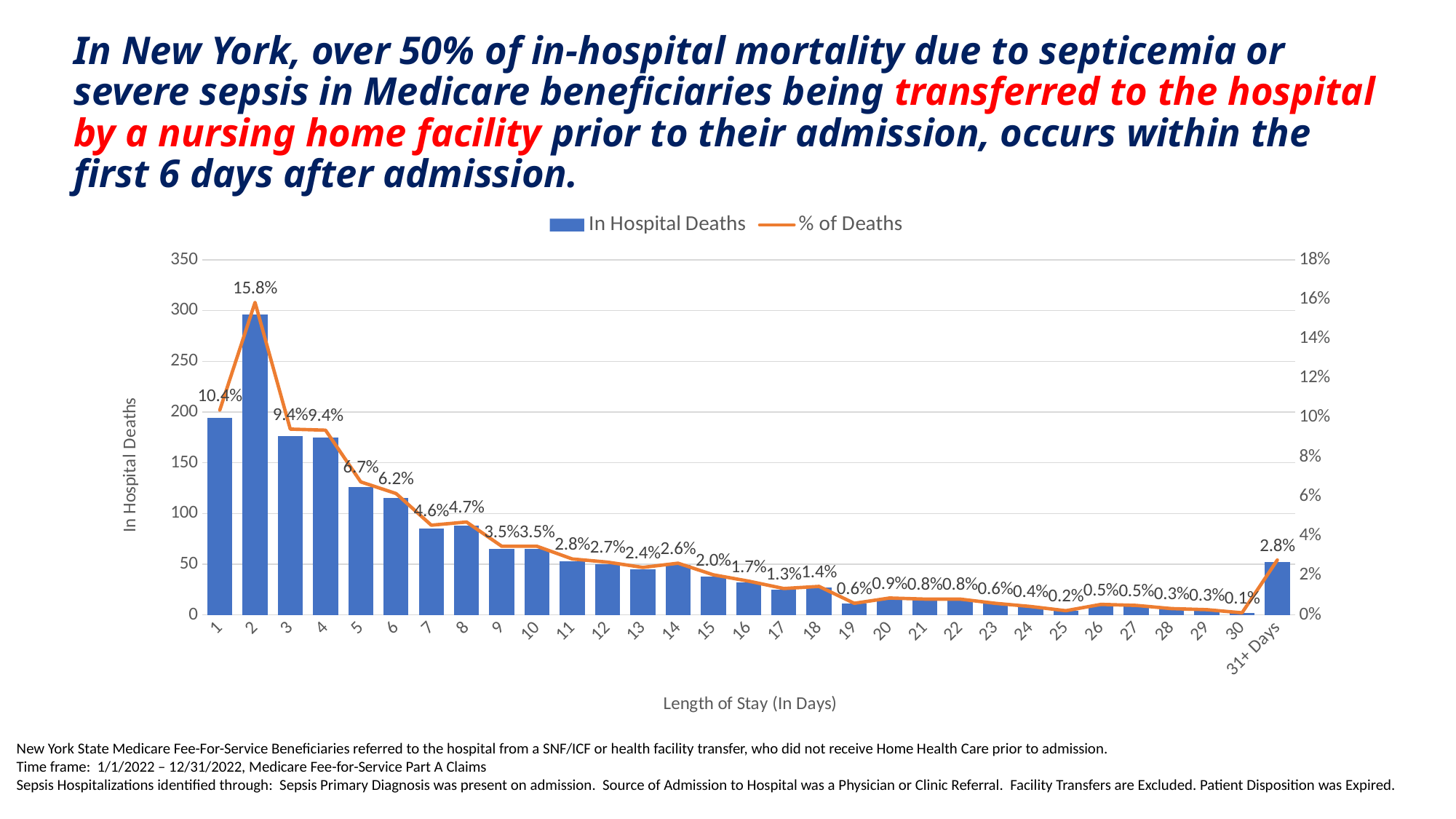
Is the In Hospital Deaths value for a length of stay of 2 days greater or less than 250? greater How many series does the legend list? 2 Which has a higher % of Deaths: a length of stay of 5 days or 6 days? 5 days Which length of stay has the lowest % of Deaths? 30 What is the % of Deaths value for a length of stay of 1 day? 10.4% What is the % of Deaths value for the 31+ Days category? 2.8% What is the % of Deaths value for a length of stay of 2 days? 15.8% Which length of stay has the highest % of Deaths? 2 How many length-of-stay categories are shown on the x axis? 31 What is the label of the x axis? Length of Stay (In Days) What is the difference in % of Deaths between a length of stay of 2 days and 1 day? 5.4%